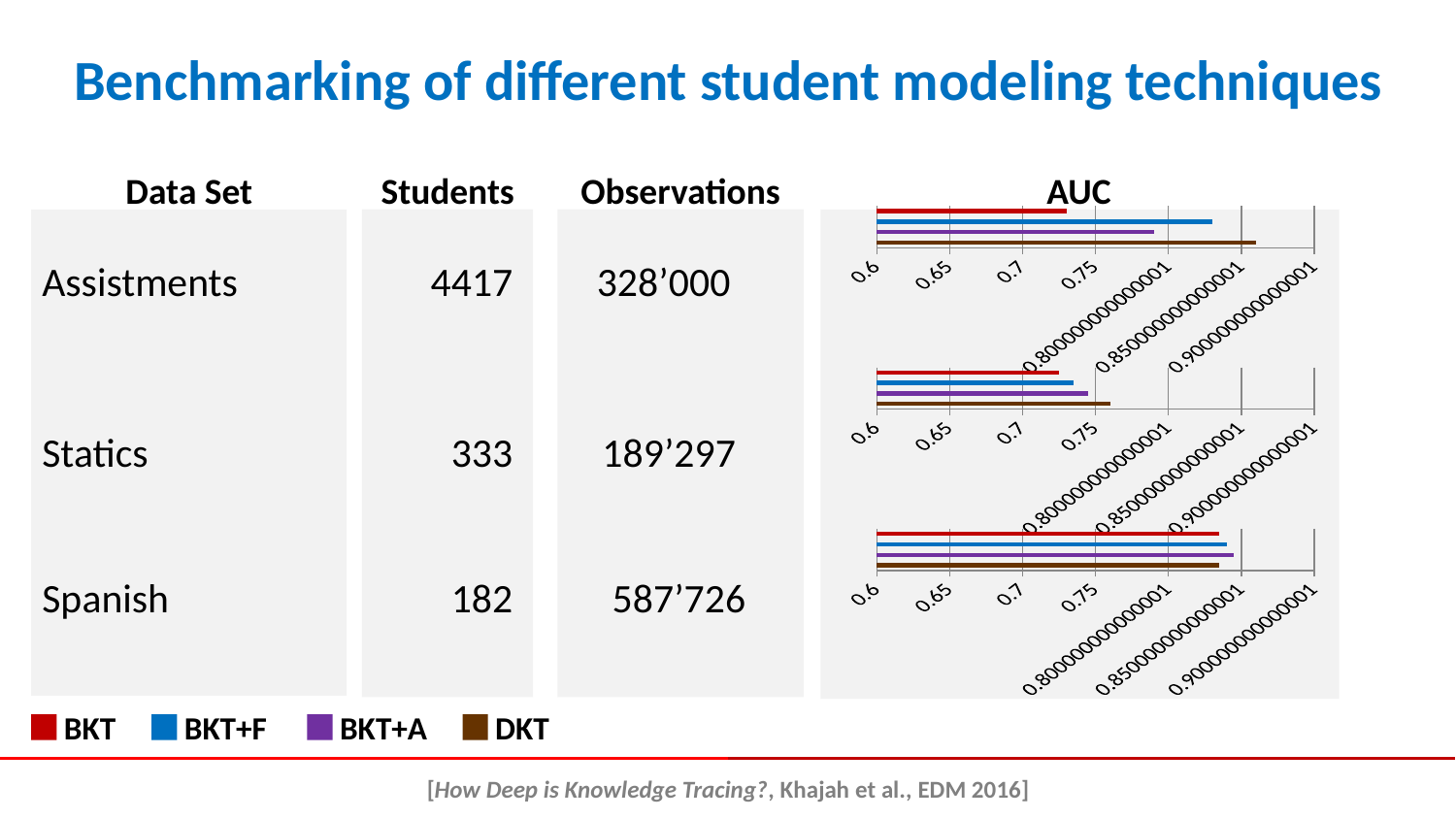
In the Assistments AUC chart, which is larger, the AUC for BKT+F or for BKT+A? BKT+F What kind of chart is used to show the AUC values for each data set? bar chart In the Assistments AUC chart, which technique has the highest AUC? DKT How many bars are plotted in the AUC chart for the Assistments data set? 4 In the Assistments AUC chart, which technique has the lowest AUC? BKT In the Assistments AUC chart, is the value for BKT+F greater or less than 0.8? greater How many series does the legend list for the AUC charts? 4 In the Spanish AUC chart, is the value for BKT greater or less than 0.8? greater In the Statics AUC chart, which technique has the highest AUC? DKT In the Assistments AUC chart, is the value for BKT greater or less than 0.75? less In the Statics AUC chart, which technique has the lowest AUC? BKT Which colour represents DKT in the legend of the AUC charts? brown